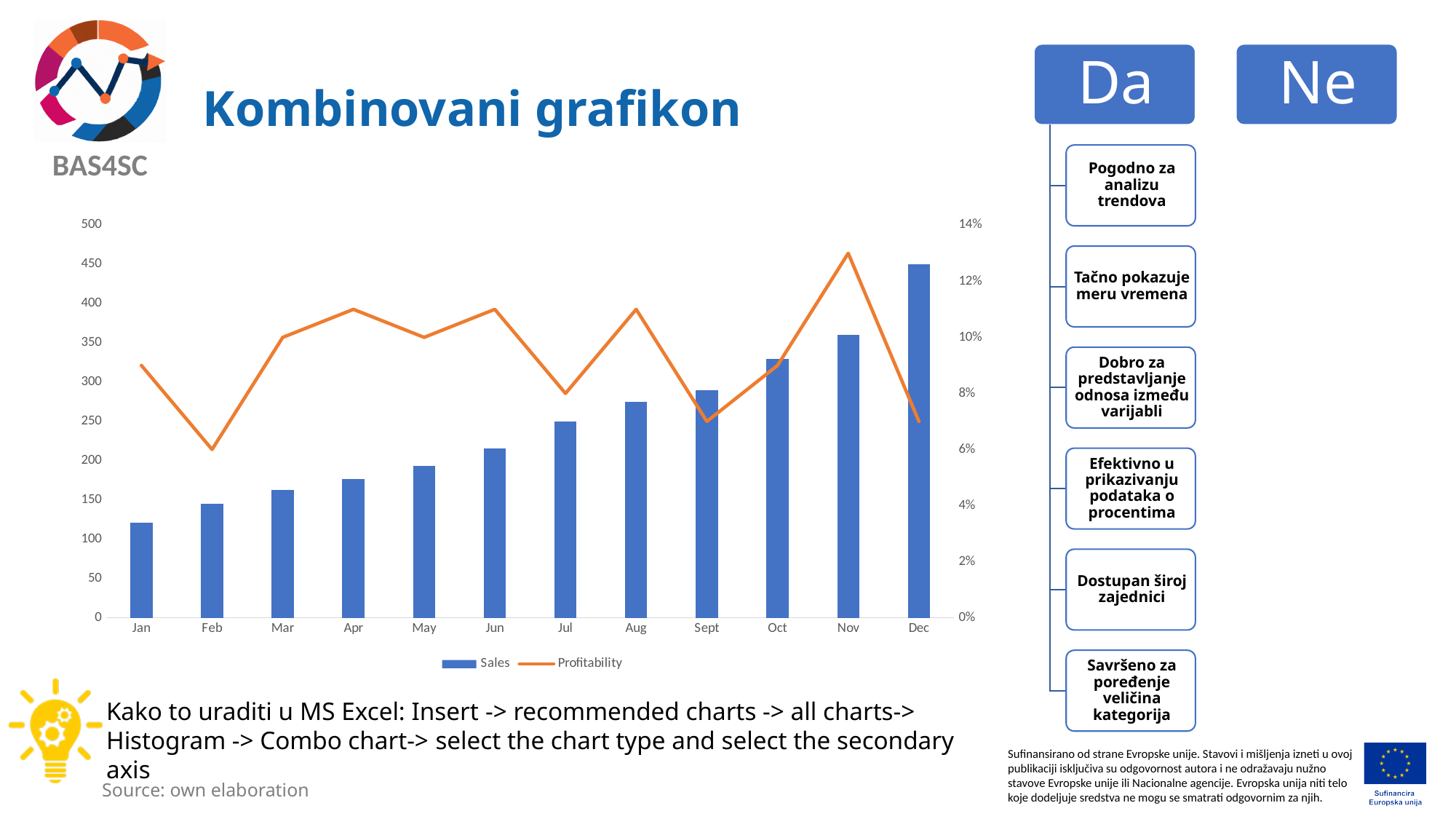
In which month does the Profitability line reach its highest point? Nov Do the Sales bars rise or fall from Jan to Dec? Rise Is the Profitability value for Nov greater or less than 12%? greater In which month does the Profitability line reach its lowest point? Feb Which month has the lowest Sales bar? Jan Which month has higher Sales, Oct or Sept? Oct What are the two series named in the legend? Sales and Profitability How many series does the chart legend list? 2 Which month has the highest Sales bar? Dec Is the Sales value for Dec greater or less than 400? greater How many months are shown on the x axis of the chart? 12 What kind of chart is shown on the slide? Combination bar and line chart